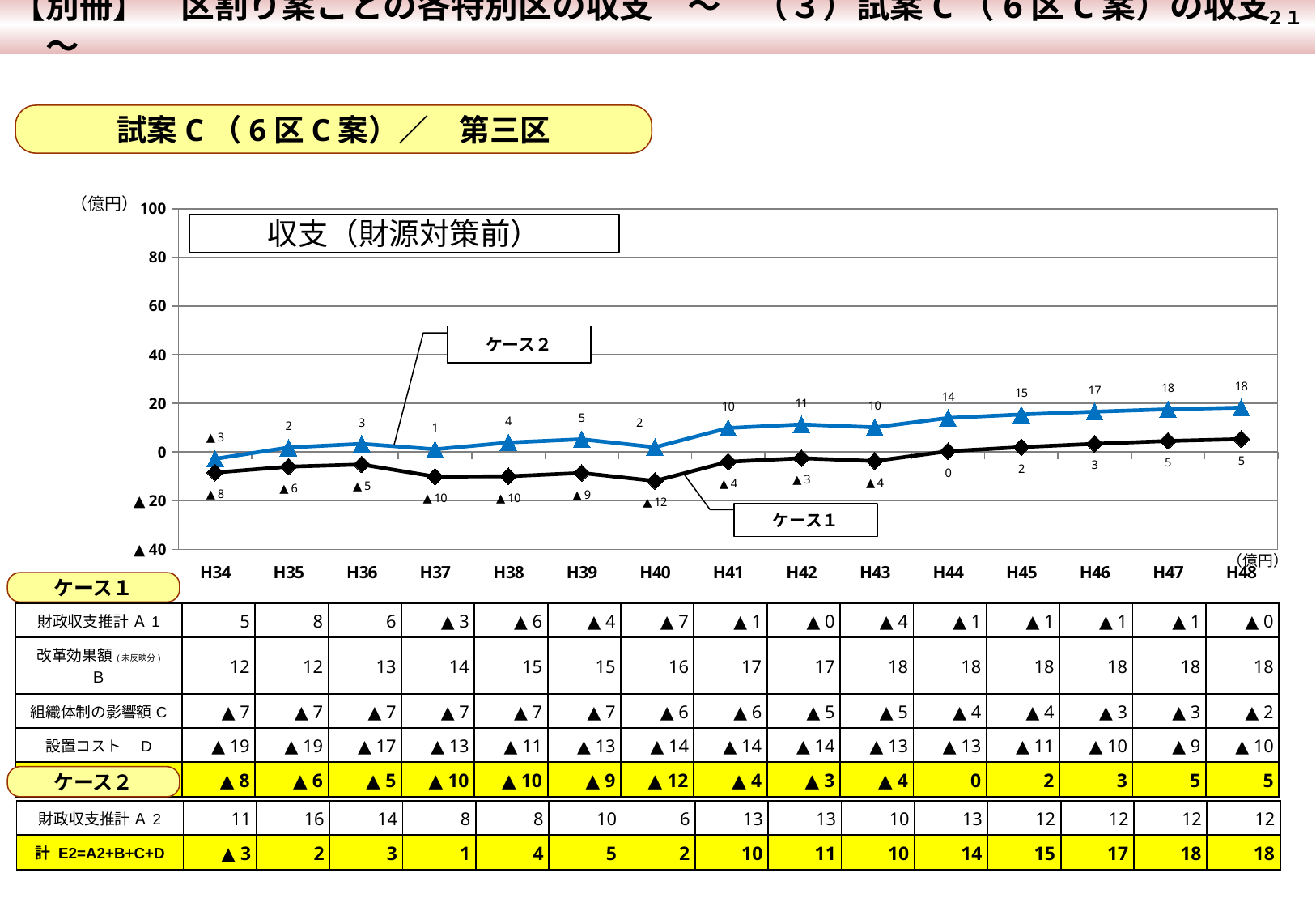
How many series are plotted in the chart? 2 What is the value for ケース2 at H42? 11 Which series has the larger value at H41, ケース1 or ケース2? ケース2 In which year does ケース1 reach its lowest value? H40 What is the value for ケース1 at H40? ▲12 What is the value for ケース2 at H34? ▲3 How many years (points) are plotted along the x axis of the chart? 15 What is the difference between ケース2 and ケース1 at H48? 13 Does the ケース2 line generally rise or fall from H40 to H48? rise What is the highest value reached by ケース2? 18 What type of chart is shown on the slide? line chart What is the title shown inside the chart area? 収支（財源対策前）